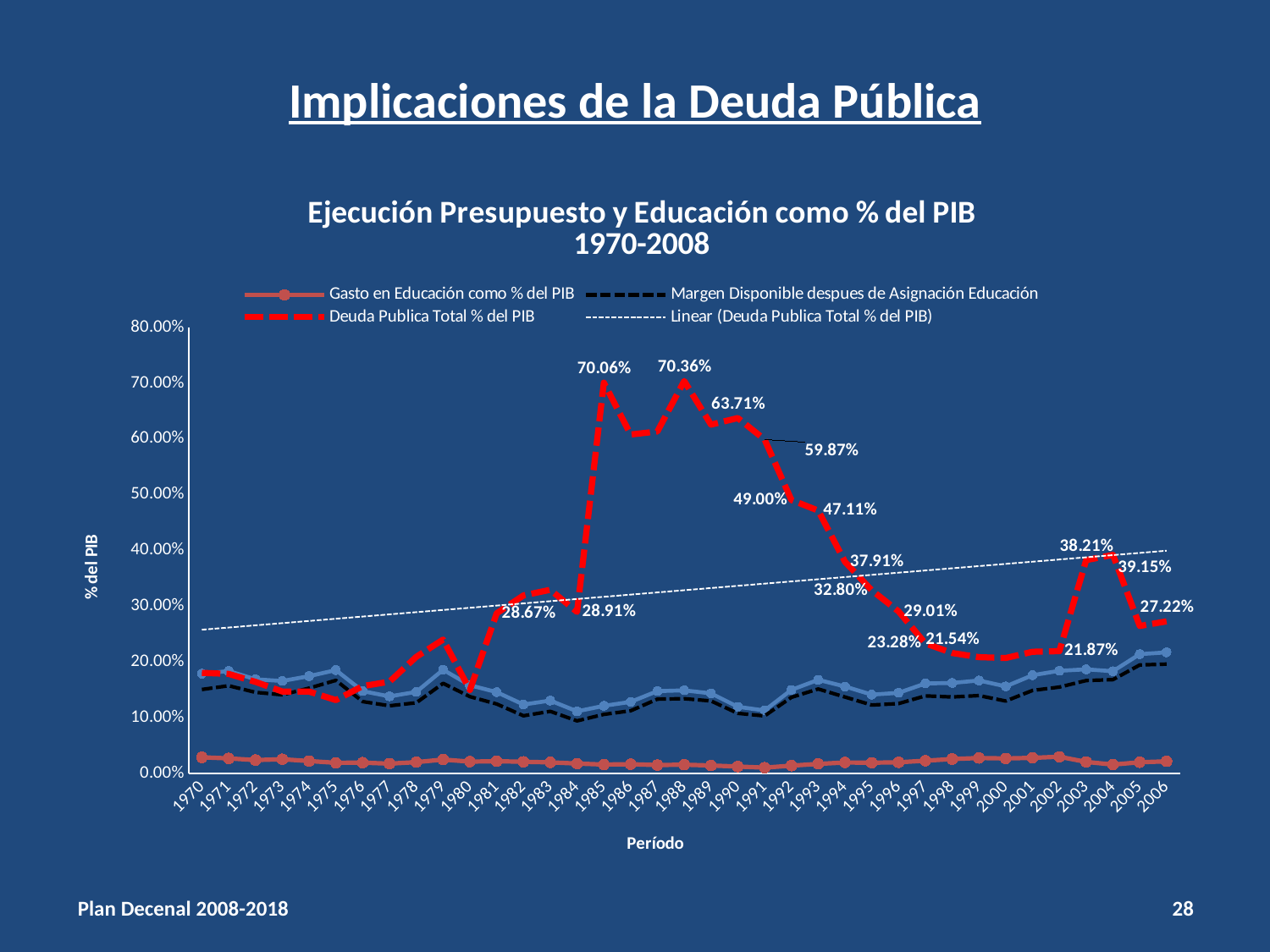
Is the value of Deuda Publica Total % del PIB in 1986 greater or less than 50.00%? greater What is the label on the y axis of the chart? % del PIB What is the highest labeled value on the Deuda Publica Total % del PIB line? 70.36% How many years are plotted along the x axis? 37 What is the labeled value of Deuda Publica Total % del PIB for 2006? 27.22% What is the difference between the two labeled peaks of Deuda Publica Total, 70.36% and 70.06%? 0.30% Is the value of Gasto en Educación como % del PIB in 1990 greater or less than 10.00%? less Does the Linear (Deuda Publica Total % del PIB) trendline rise or fall from 1970 to 2006? rise What kind of chart is shown on the slide? line chart Which labeled Deuda Publica Total value is larger, 38.21% or 39.15%? 39.15% How many series does the legend list? 4 What is the labeled value of Deuda Publica Total % del PIB at the 1985 peak? 70.06%